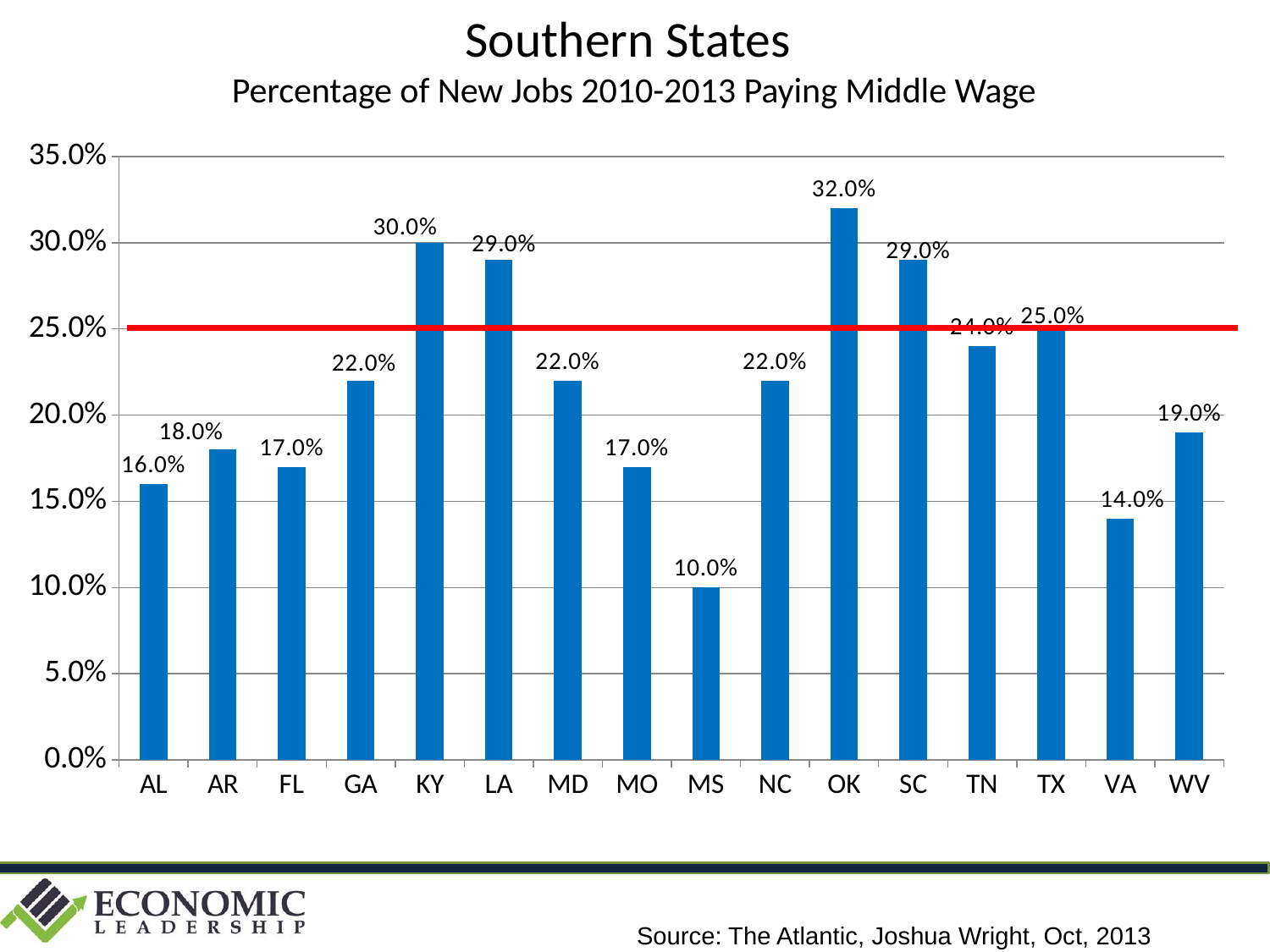
At what value is the red horizontal line drawn? 25.0% What is the value for KY? 30.0% Is the value for VA greater or less than 15.0%? less How many states are shown on the x axis? 16 What is the difference between the values for OK and MS? 22.0% Which state has the lowest percentage? MS Which is larger, the value for GA or the value for FL? GA What is the difference between the values for LA and WV? 10.0% Which state has the highest percentage? OK What is the value for MS? 10.0% What is the value for OK? 32.0% What kind of chart is this? bar chart